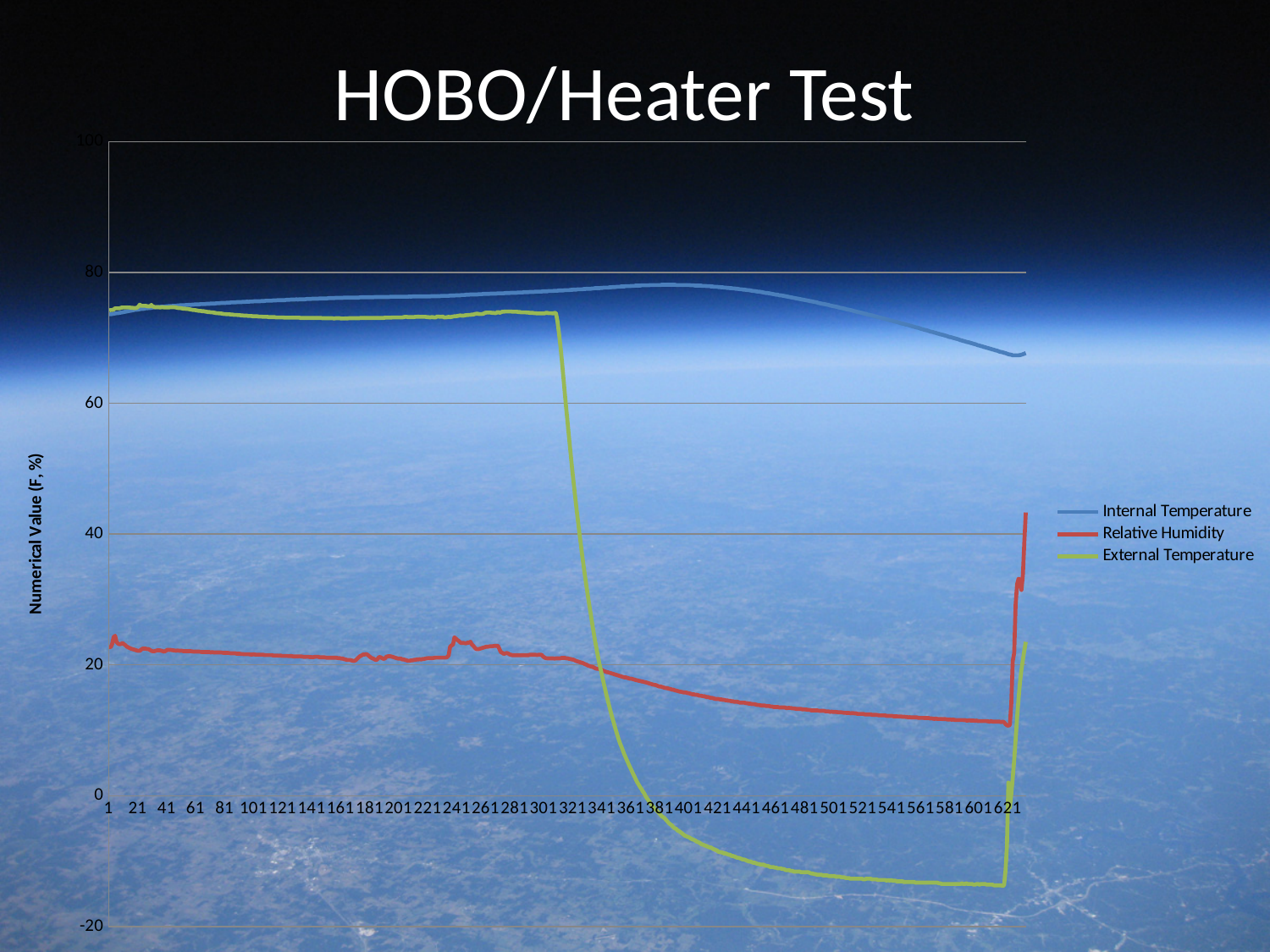
How many series does the legend list? 3 What kind of chart is shown on the slide? line chart Is the value for Relative Humidity at x = 201 greater or less than 40? less At x = 401, which series has the higher value, Internal Temperature or External Temperature? Internal Temperature Does the External Temperature line rise or fall between x = 321 and x = 381? fall What is the title of the chart? HOBO/Heater Test Is the value for Internal Temperature at x = 1 greater or less than 60? greater Which series reaches the lowest value anywhere on the chart? External Temperature What is the label on the vertical axis? Numerical Value (F, %) Does the Relative Humidity line rise or fall between x = 341 and x = 601? fall Is the value for External Temperature at x = 501 greater or less than 0? less